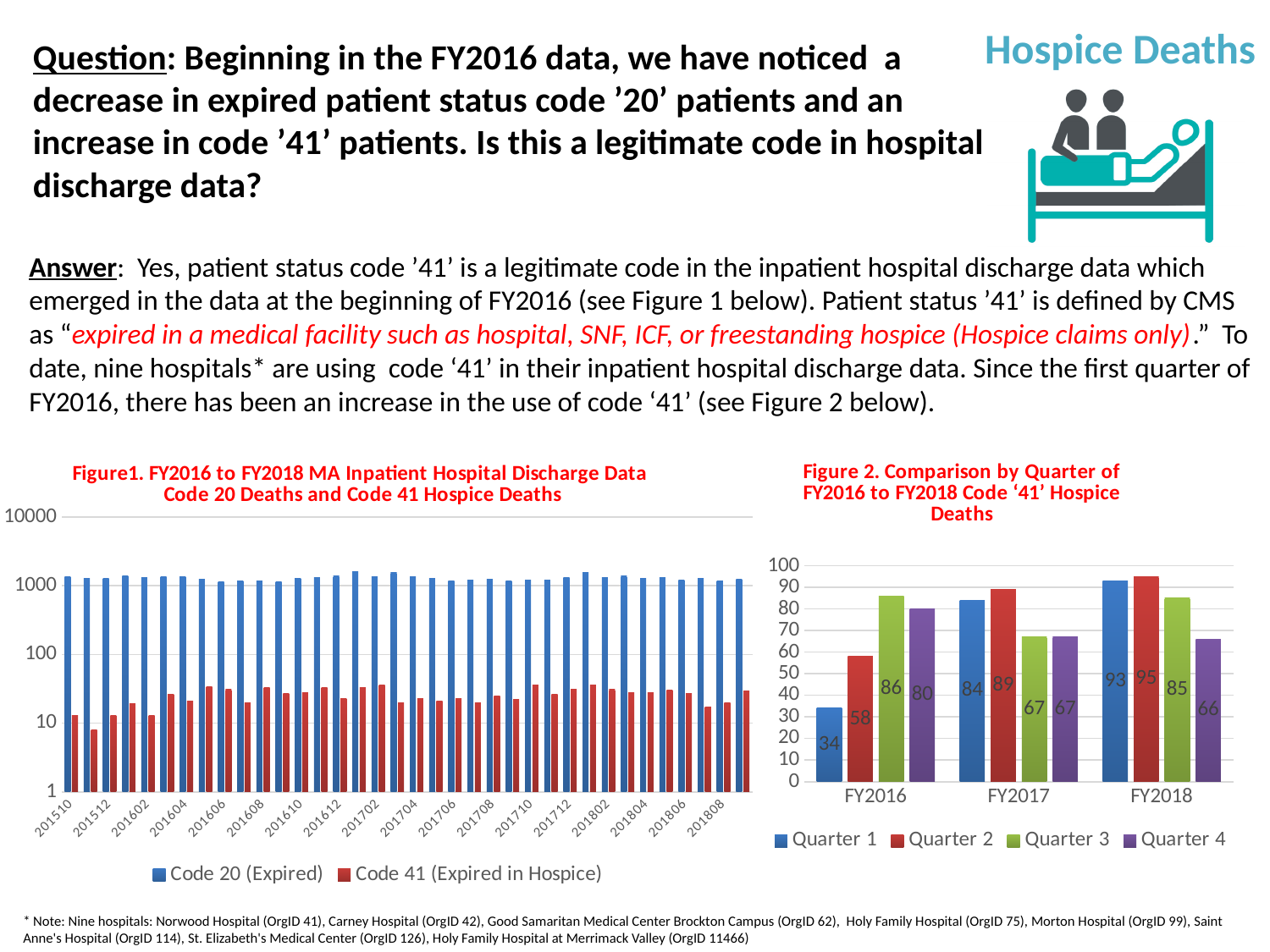
In Figure 1, is the value for Code 41 (Expired in Hospice) in 201510 greater or less than 100? less In Figure 2, what is the difference between the Quarter 1 value for FY2018 and the Quarter 1 value for FY2016? 59 In Figure 2, how many series does the legend list? 4 In Figure 2, what is the value for Quarter 1 in FY2016? 34 In Figure 2, how many fiscal years are shown on the x axis? 3 In Figure 2, which is larger: Quarter 2 in FY2017 or Quarter 4 in FY2016? Quarter 2 in FY2017 In Figure 1, how many series does the legend list? 2 In Figure 2, which quarter has the lowest value in FY2018? Quarter 4 In Figure 2, what is the value for Quarter 3 in FY2017? 67 In Figure 2, do the Quarter 1 values rise or fall from FY2016 to FY2018? rise In Figure 2, which quarter has the highest value in FY2016? Quarter 3 In Figure 2, what is the value for Quarter 2 in FY2018? 95